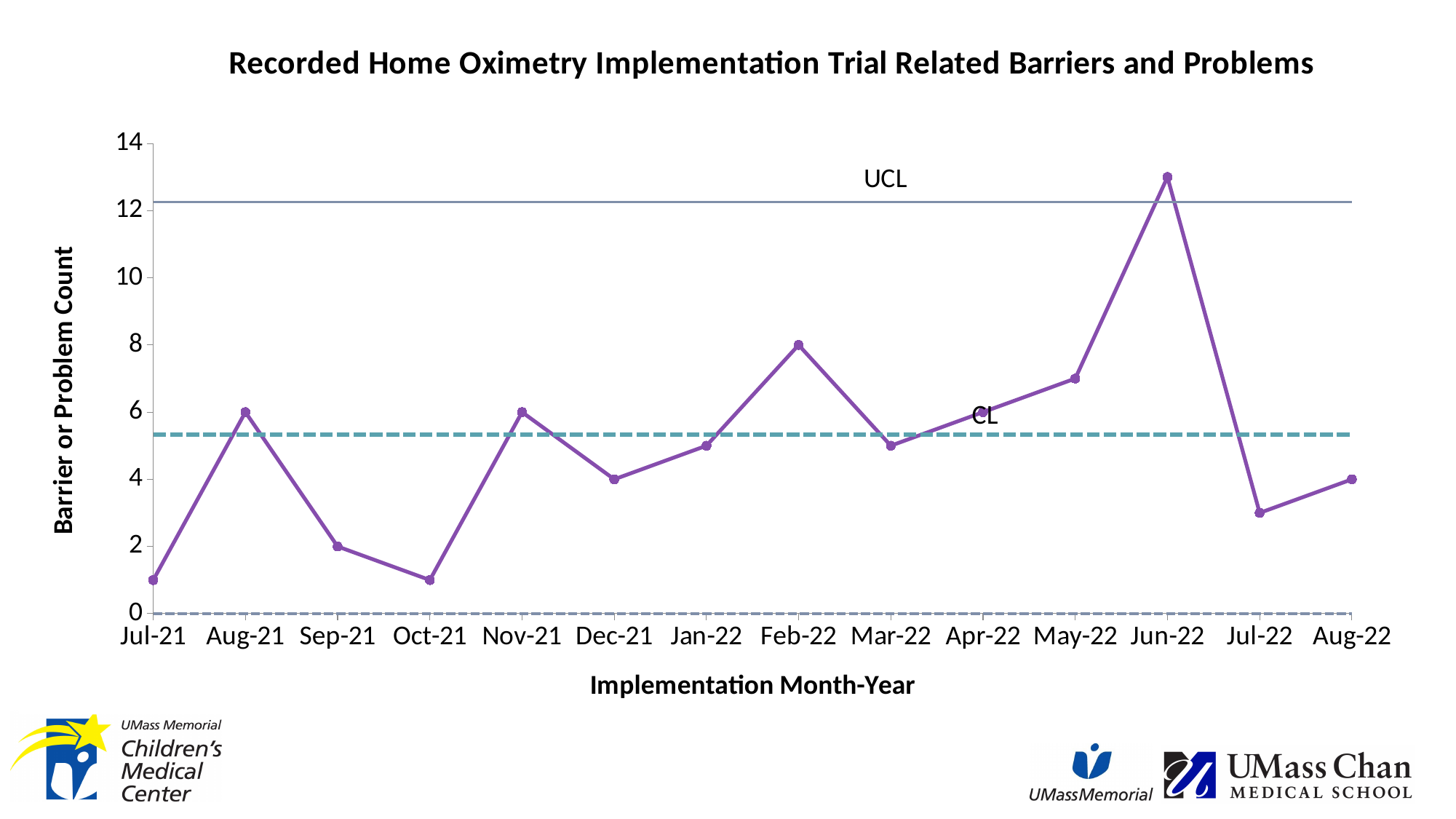
What is the barrier or problem count for Sep-21? 2 Is the value for Jul-22 greater or less than 4? less Which has a higher barrier or problem count, Feb-22 or Sep-21? Feb-22 What is the label of the y axis? Barrier or Problem Count What is the difference between the counts for Feb-22 and Dec-21? 4 What type of chart is shown on the slide? line chart How many months are plotted on the x axis? 14 What is the barrier or problem count for Aug-21? 6 What is the barrier or problem count for Feb-22? 8 What is the barrier or problem count for Dec-21? 4 Which month has the highest barrier or problem count? Jun-22 Is the value for Jun-22 greater or less than 12? greater